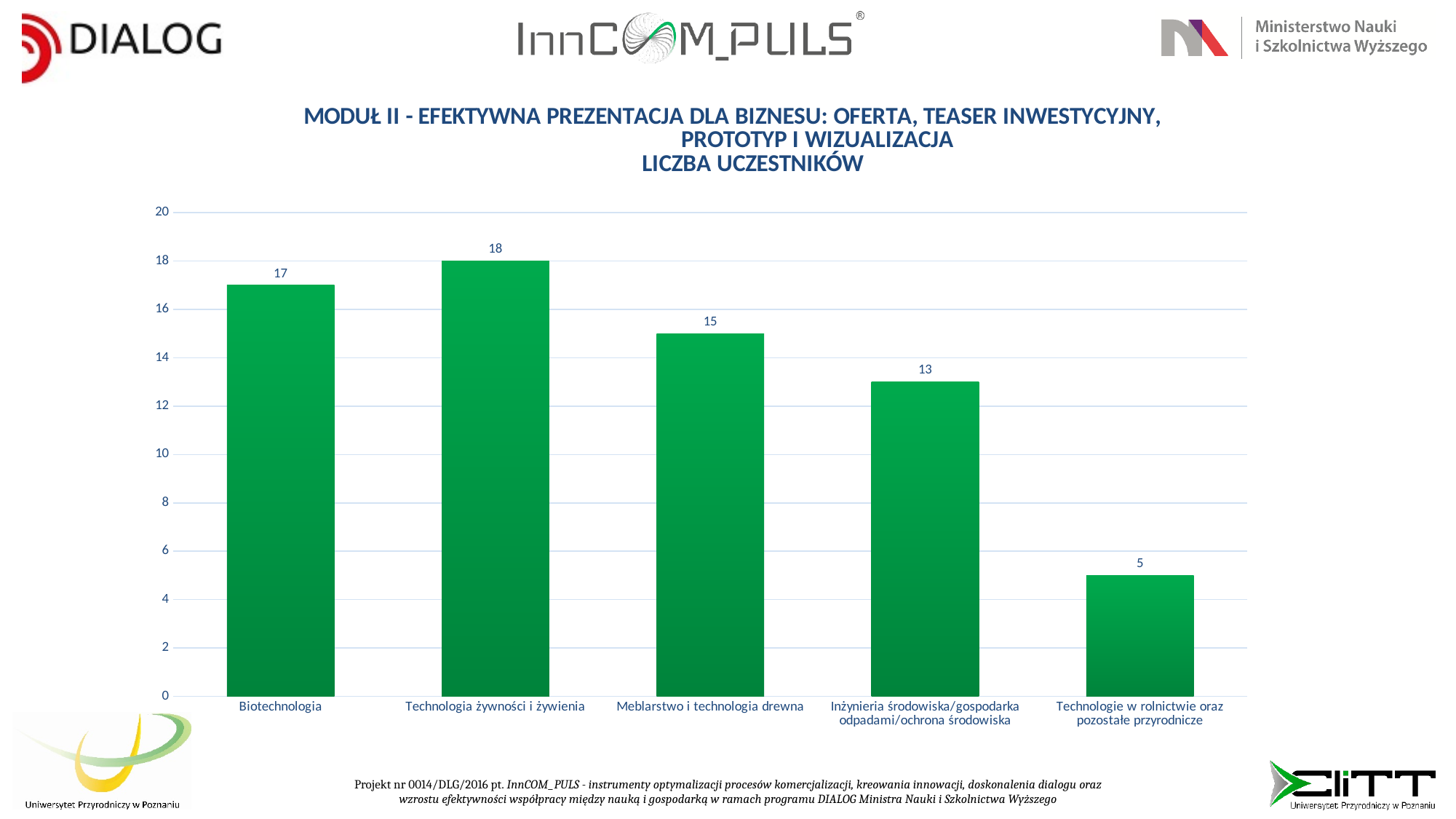
What is the value for Technologia żywności i żywienia? 18 What is the maximum value shown on the vertical axis? 20 How many participants are shown for Biotechnologia? 17 What is the difference between the values for Technologia żywności i żywienia and Inżynieria środowiska/gospodarka odpadami/ochrona środowiska? 5 How many categories are shown on the chart? 5 Which category has the lowest number of participants? Technologie w rolnictwie oraz pozostałe przyrodnicze Which category has the highest number of participants? Technologia żywności i żywienia What is the value for Meblarstwo i technologia drewna? 15 Which is larger, the value for Biotechnologia or the value for Meblarstwo i technologia drewna? Biotechnologia Is the value for Inżynieria środowiska/gospodarka odpadami/ochrona środowiska greater or less than 10? greater What kind of chart is shown on the slide? bar chart What is the value for Technologie w rolnictwie oraz pozostałe przyrodnicze? 5